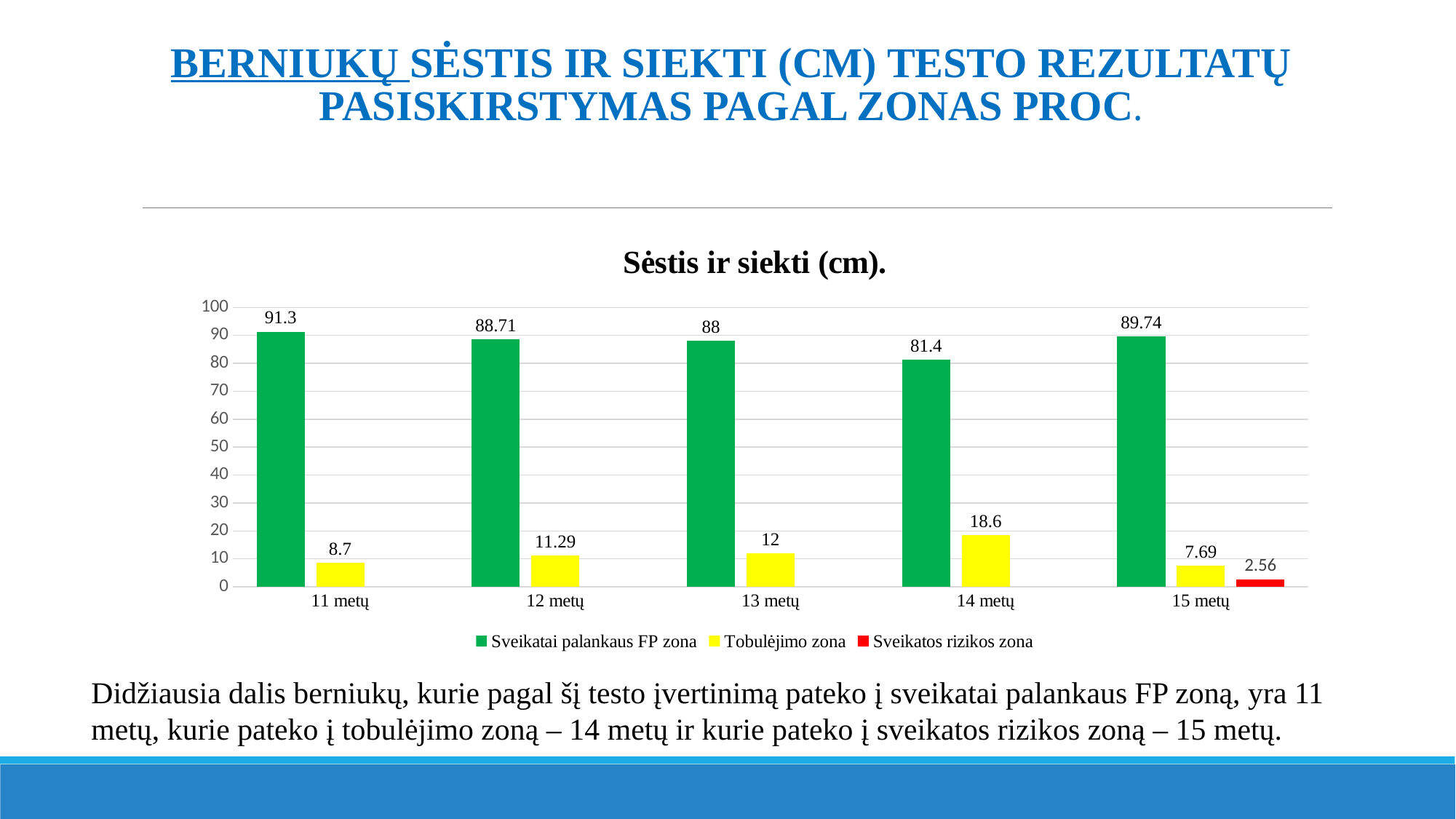
Which age group has the highest value for Sveikatai palankaus FP zona? 11 metų Is the value for Sveikatai palankaus FP zona for 14 metų greater or less than 90? less Which age group has the lowest value for Tobulėjimo zona? 15 metų How many age groups are shown on the x axis? 5 What is the value for Sveikatai palankaus FP zona for 11 metų? 91.3 What kind of chart is shown on the slide? bar chart How many series does the legend list? 3 What is the difference between the Sveikatai palankaus FP zona values for 11 metų and 14 metų? 9.9 Which is larger: the Tobulėjimo zona value for 12 metų or for 13 metų? 13 metų What is the title of the chart? Sėstis ir siekti (cm). What is the value for Tobulėjimo zona for 14 metų? 18.6 What is the value for Sveikatos rizikos zona for 15 metų? 2.56